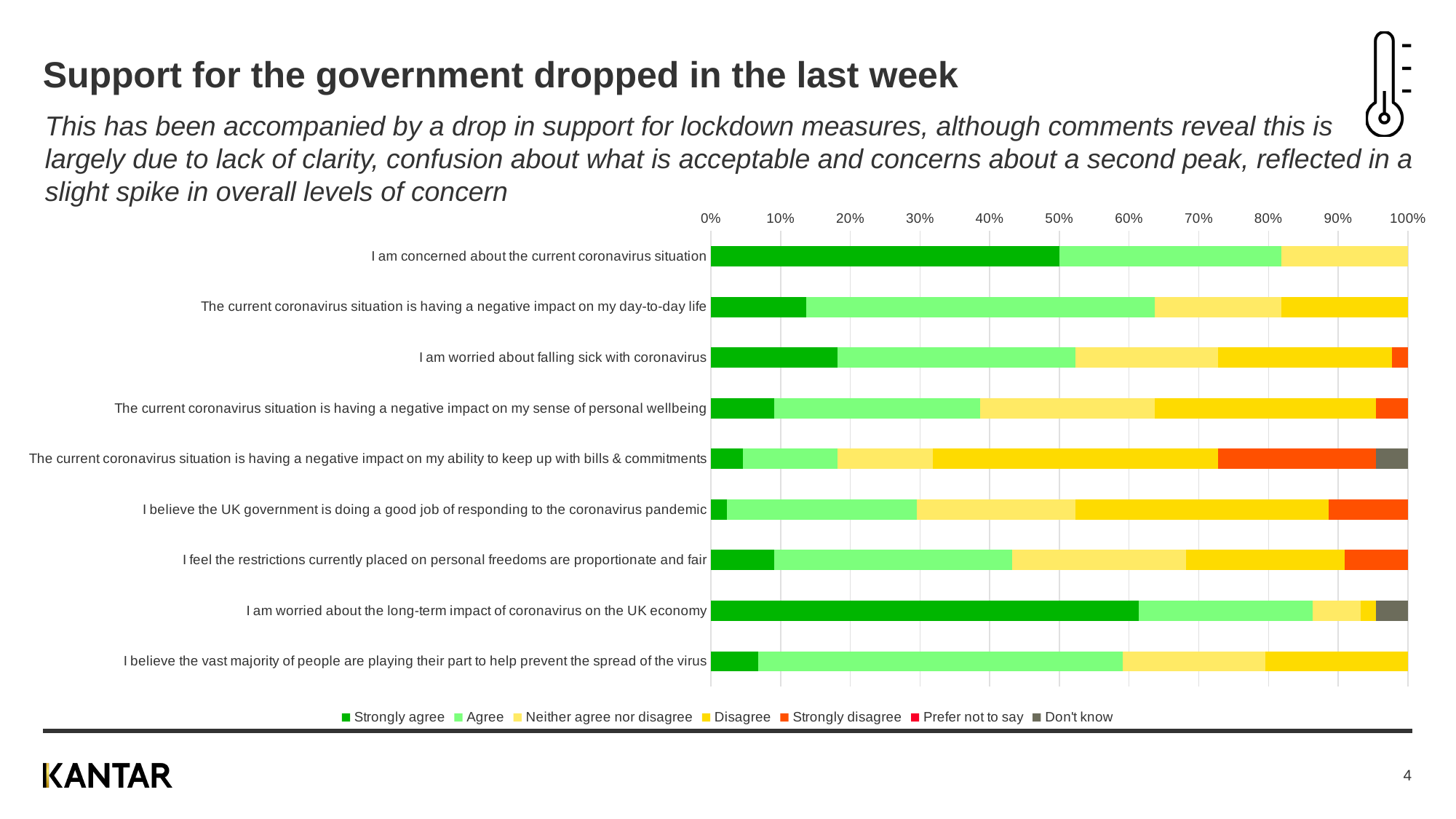
Is the 'Strongly agree' value for 'I believe the UK government is doing a good job of responding to the coronavirus pandemic' greater or less than 10%? less Is the 'Strongly agree' value for 'I am concerned about the current coronavirus situation' greater or less than 40%? greater How many series does the legend list? 7 Is the 'Strongly agree' value for 'The current coronavirus situation is having a negative impact on my day-to-day life' greater or less than 10%? greater What colour represents 'Strongly disagree' in the legend? Orange Which statement has the largest 'Strongly agree' segment? I am worried about the long-term impact of coronavirus on the UK economy What kind of chart is shown on the slide? Stacked bar chart Which statement has the smallest 'Strongly agree' segment? I believe the UK government is doing a good job of responding to the coronavirus pandemic What is the highest value shown on the percentage axis? 100% Which has the larger 'Strongly agree' segment: 'I am concerned about the current coronavirus situation' or 'The current coronavirus situation is having a negative impact on my day-to-day life'? I am concerned about the current coronavirus situation How many statements (categories) are plotted in the chart? 9